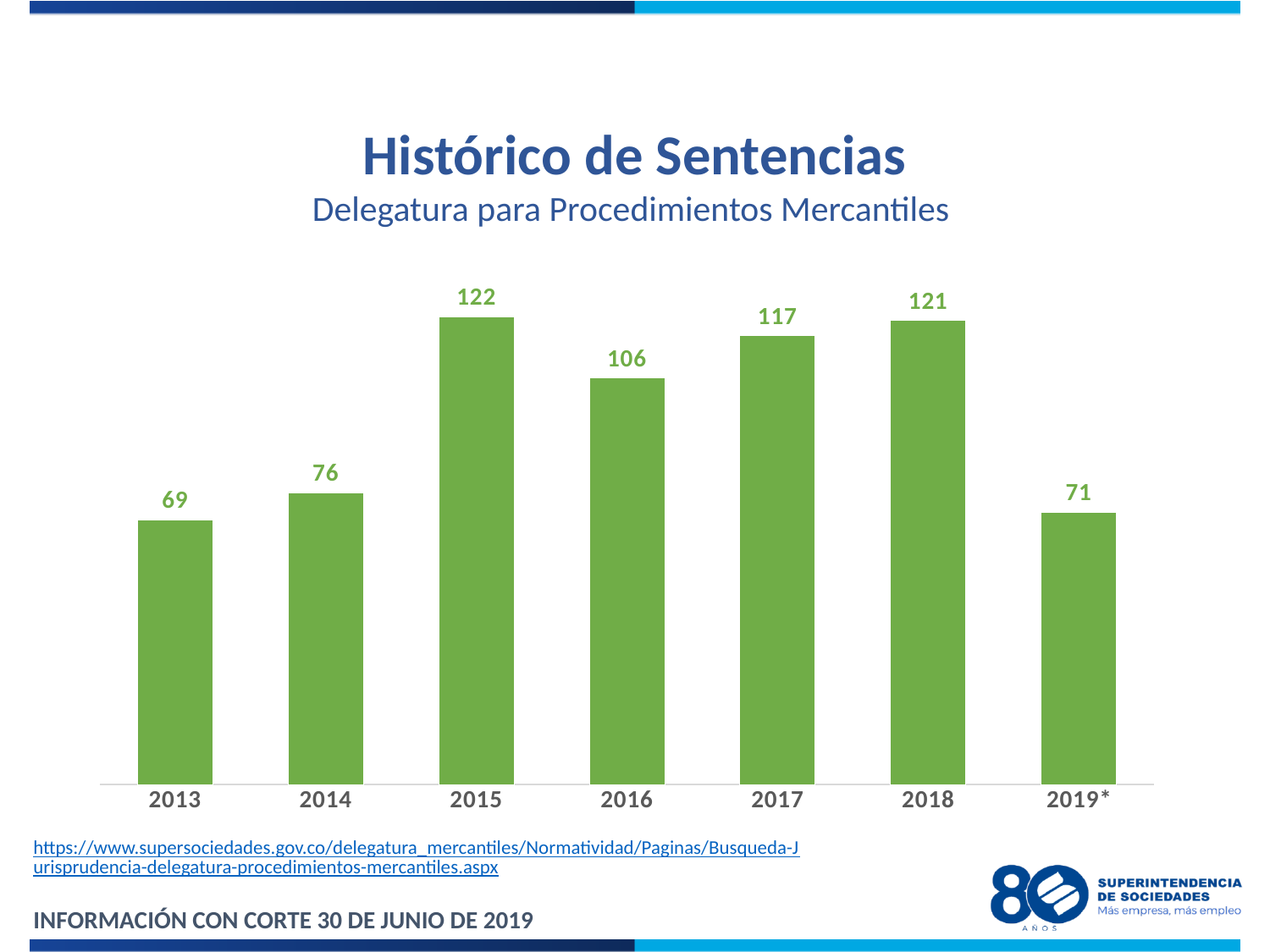
What is the value for 2015? 122 What is the title of the chart? Histórico de Sentencias Which is larger, the value for 2017 or the value for 2018? 2018 How many years are shown on the x axis? 7 What is the value for 2019*? 71 Do the values rise or fall from 2013 to 2015? rise Which year has the lowest value? 2013 What is the difference between the values for 2014 and 2013? 7 What kind of chart is this? bar chart Which year has the highest value? 2015 What is the value for 2017? 117 What is the difference between the values for 2018 and 2016? 15